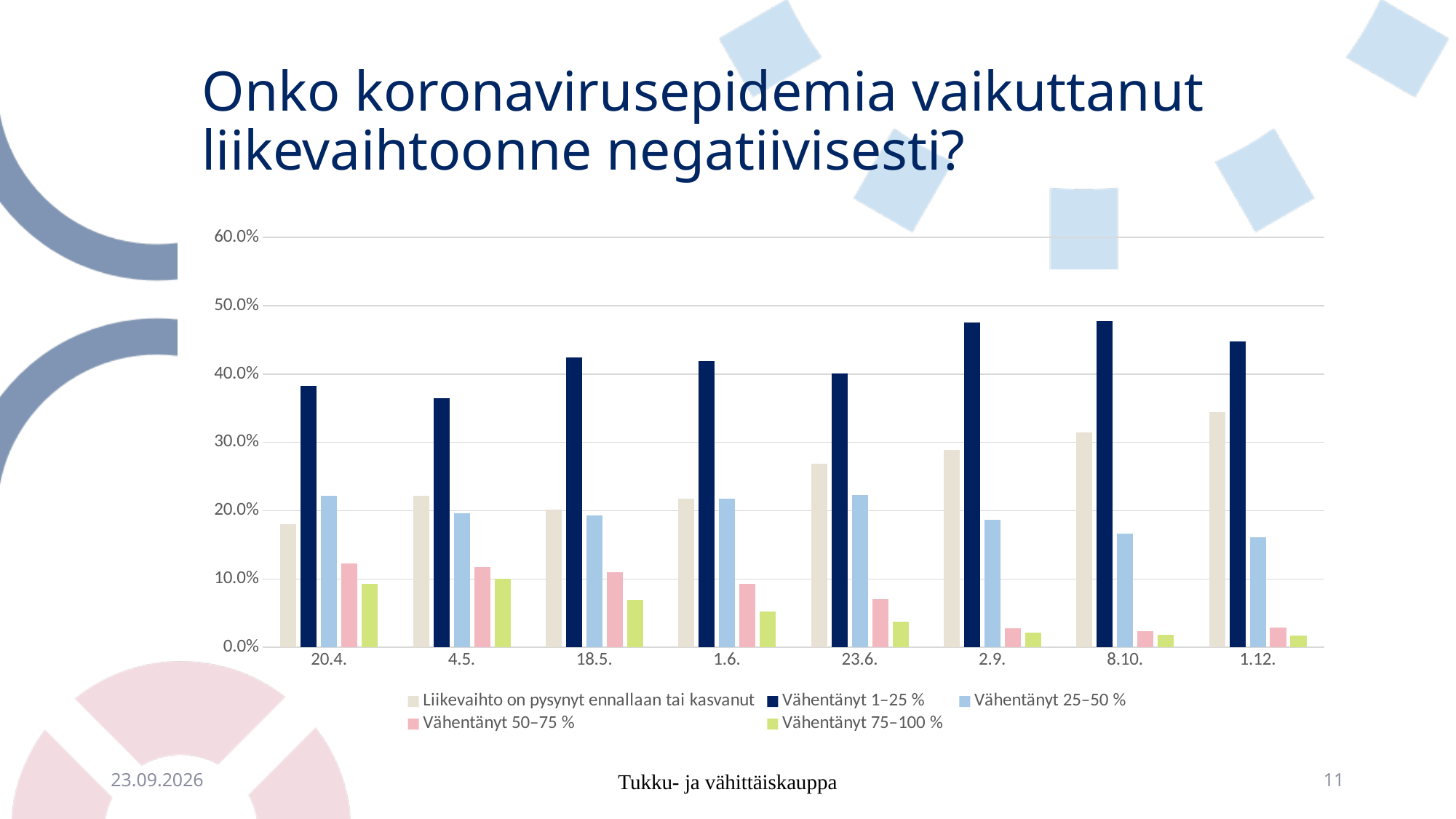
At 20.4., which is larger: 'Vähentänyt 25–50 %' or 'Liikevaihto on pysynyt ennallaan tai kasvanut'? Vähentänyt 25–50 % How many series does the chart's legend list? 5 Which date has the lowest value for 'Liikevaihto on pysynyt ennallaan tai kasvanut'? 20.4. Which date has the highest value for 'Liikevaihto on pysynyt ennallaan tai kasvanut'? 1.12. How many dates (categories) are shown on the x axis of the chart? 8 What kind of chart is shown on the slide? Bar chart Does the value for 'Liikevaihto on pysynyt ennallaan tai kasvanut' rise or fall from 23.6. to 1.12.? rise Does the value for 'Vähentänyt 75–100 %' generally rise or fall from 20.4. to 1.12.? fall Is the value for 'Vähentänyt 1–25 %' at 18.5. greater or less than 40.0%? greater What colour represents the 'Vähentänyt 1–25 %' series in the chart? Dark navy blue Is the value for 'Vähentänyt 1–25 %' at 20.4. greater or less than 40.0%? less Is the value for 'Vähentänyt 25–50 %' at 1.12. greater or less than 20.0%? less